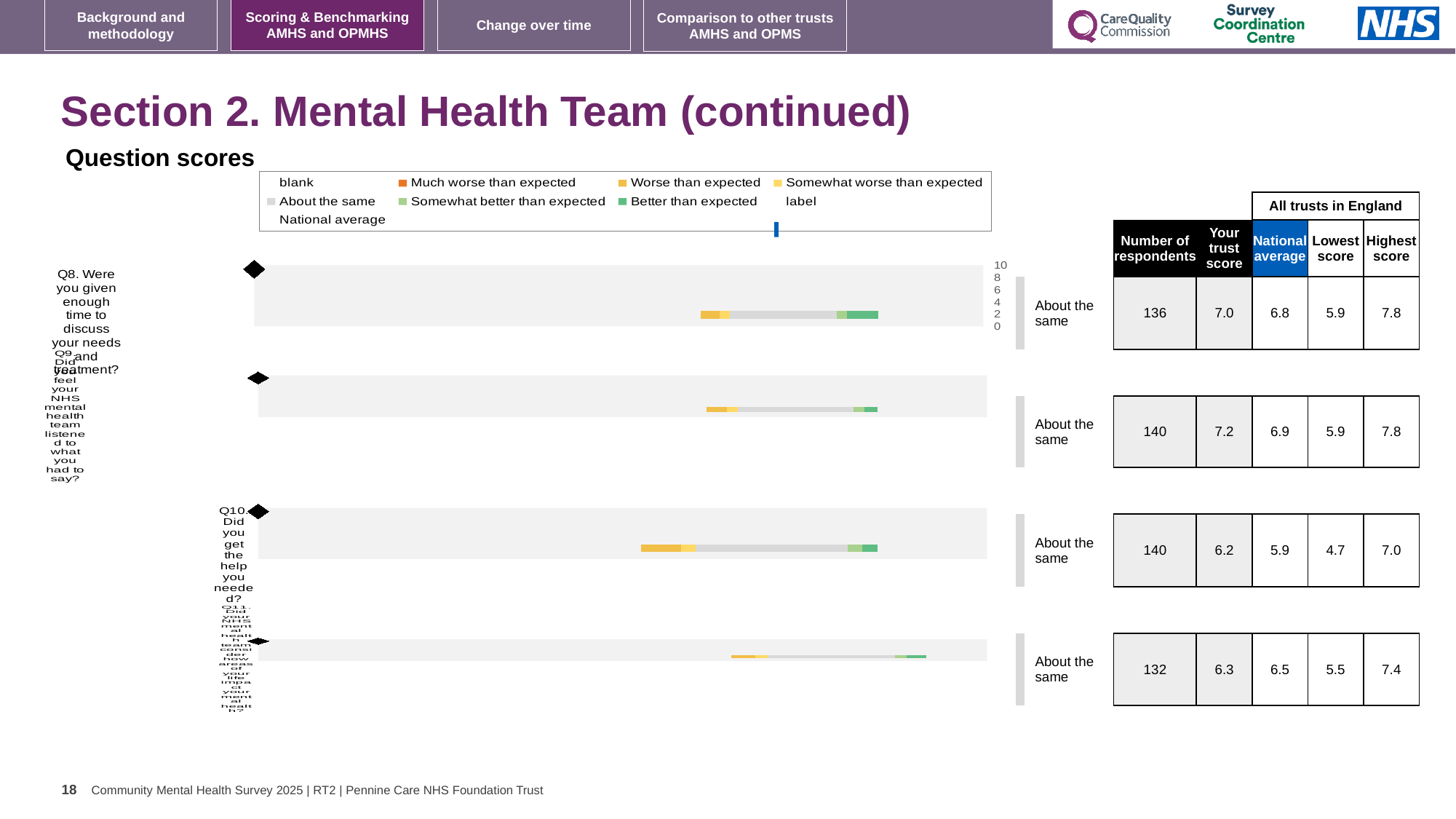
In the table beside the charts, what is the number of respondents for Q11? 132 What colour in the legend represents 'Much worse than expected'? orange What kind of chart is used to show the question scores on this slide? bar chart For Q10, which is larger: 'Your trust score' or the 'National average'? Your trust score Which question has the highest 'Your trust score' in the table? Q9 Which question has the lowest number of respondents in the table? Q11 How many entries does the legend above the question score charts list? 9 How many question bars (Q8 to Q11) are plotted on the slide? 4 In the table beside the charts, what is 'Your trust score' for Q9? 7.2 For Q8, what is the difference between the highest score and the lowest score across all trusts in England? 1.9 What is the heading printed above the question score charts? Question scores What benchmark category is shown next to the bar for Q8? About the same